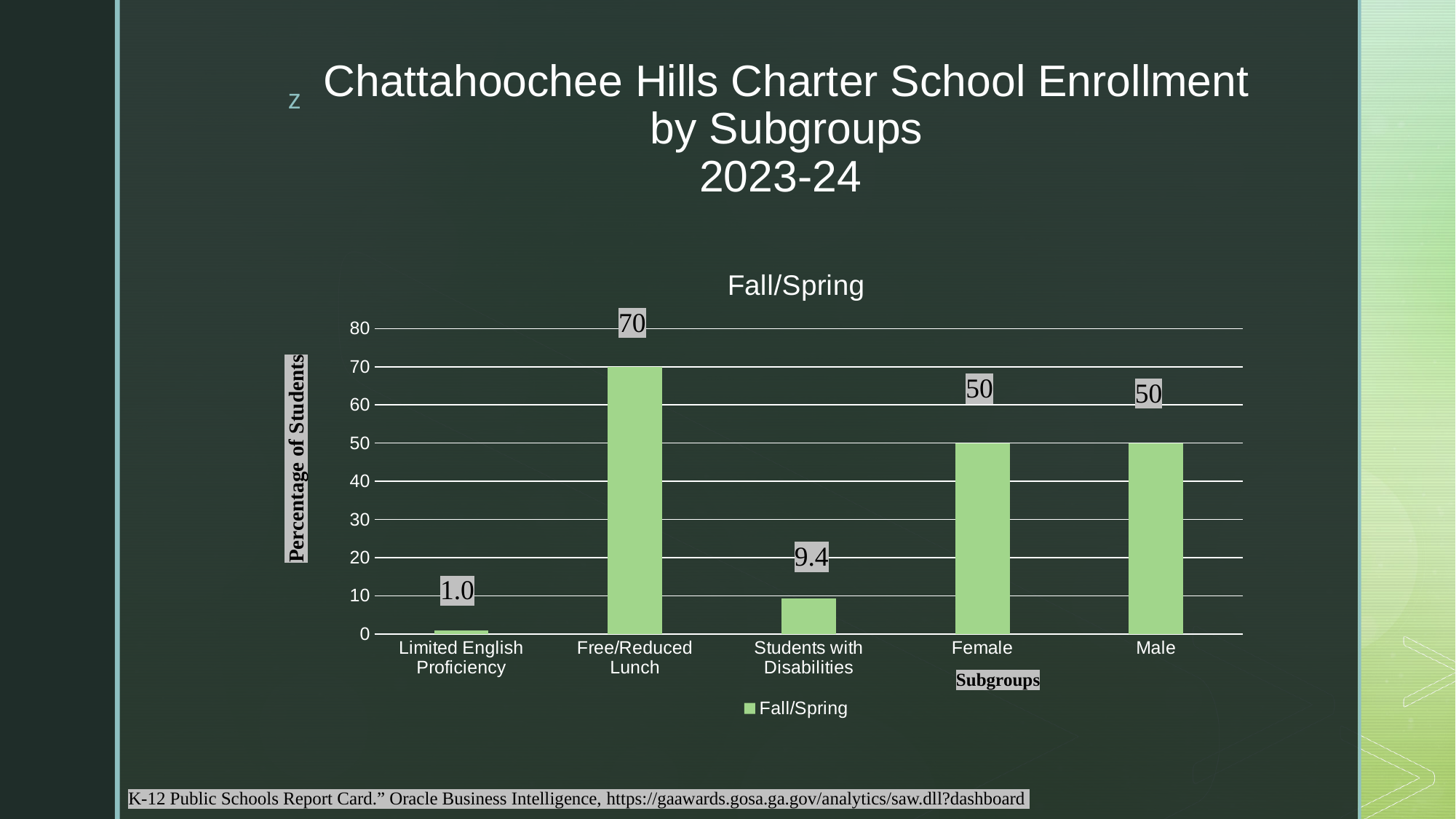
What is the value for Female? 50 Which is larger, the value for Students with Disabilities or the value for Male? Male Which subgroup has the highest value? Free/Reduced Lunch What is the value for Free/Reduced Lunch? 70 What is the value for Students with Disabilities? 9.4 What kind of chart is shown on the slide? bar chart What is the value for Limited English Proficiency? 1.0 What is the difference between the values for Free/Reduced Lunch and Female? 20 How many subgroups are shown on the x axis? 5 Is the value for Students with Disabilities greater or less than 10? less Which subgroup has the lowest value? Limited English Proficiency What is the label of the y axis? Percentage of Students